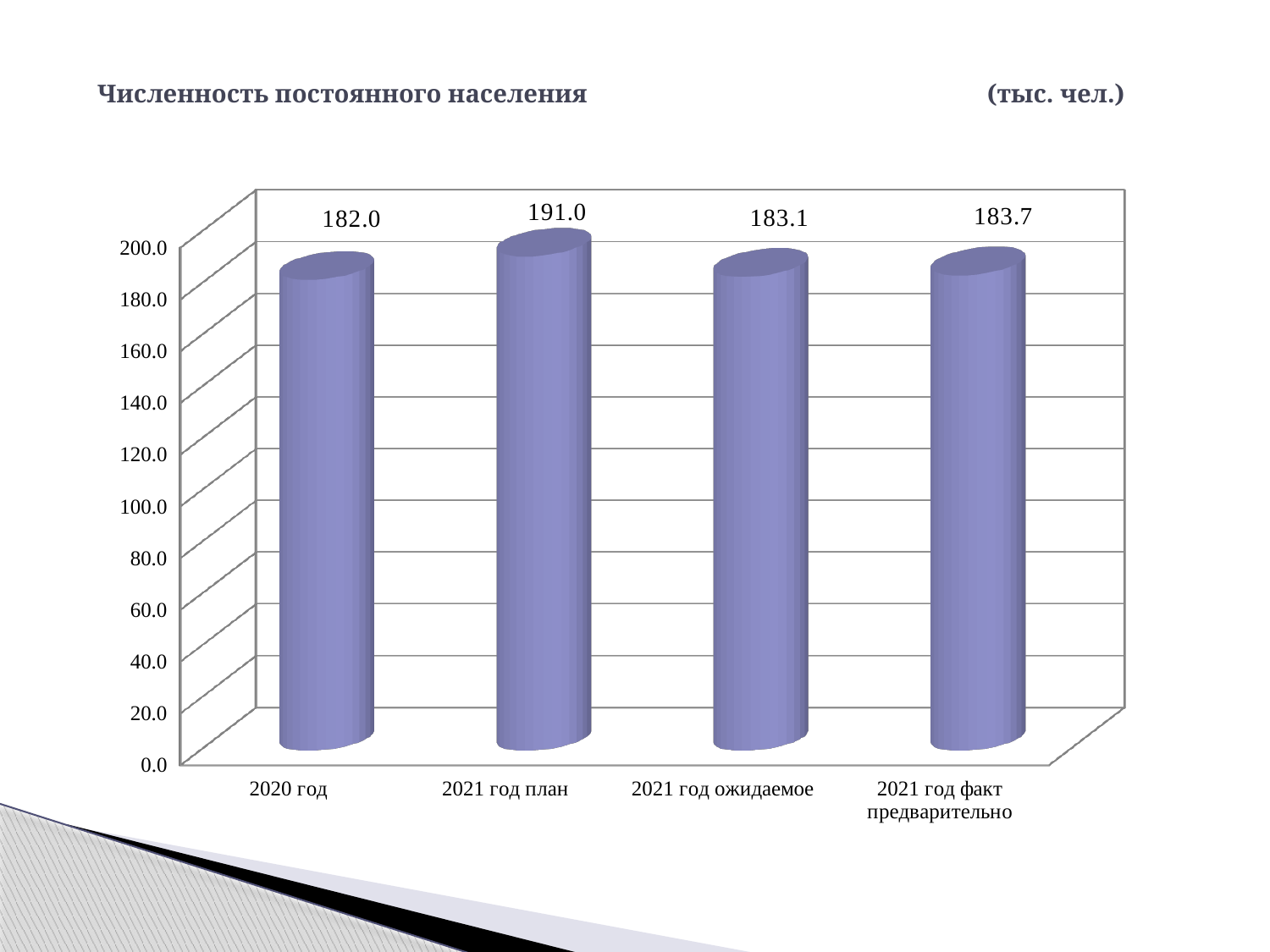
Which category has the highest value? 2021 год план What is the value for 2021 год ожидаемое? 183.1 Which is larger, the value for 2021 год план or the value for 2021 год ожидаемое? 2021 год план Which category has the lowest value? 2020 год What is the value for 2021 год факт предварительно? 183.7 What is the difference between the values for 2021 год план and 2020 год? 9.0 What is the value for 2020 год? 182.0 What is the difference between the values for 2021 год факт предварительно and 2021 год ожидаемое? 0.6 What kind of chart is shown on the slide? bar chart What is the value for 2021 год план? 191.0 What is the title of the chart? Численность постоянного населения (тыс. чел.) How many categories are shown on the x axis? 4